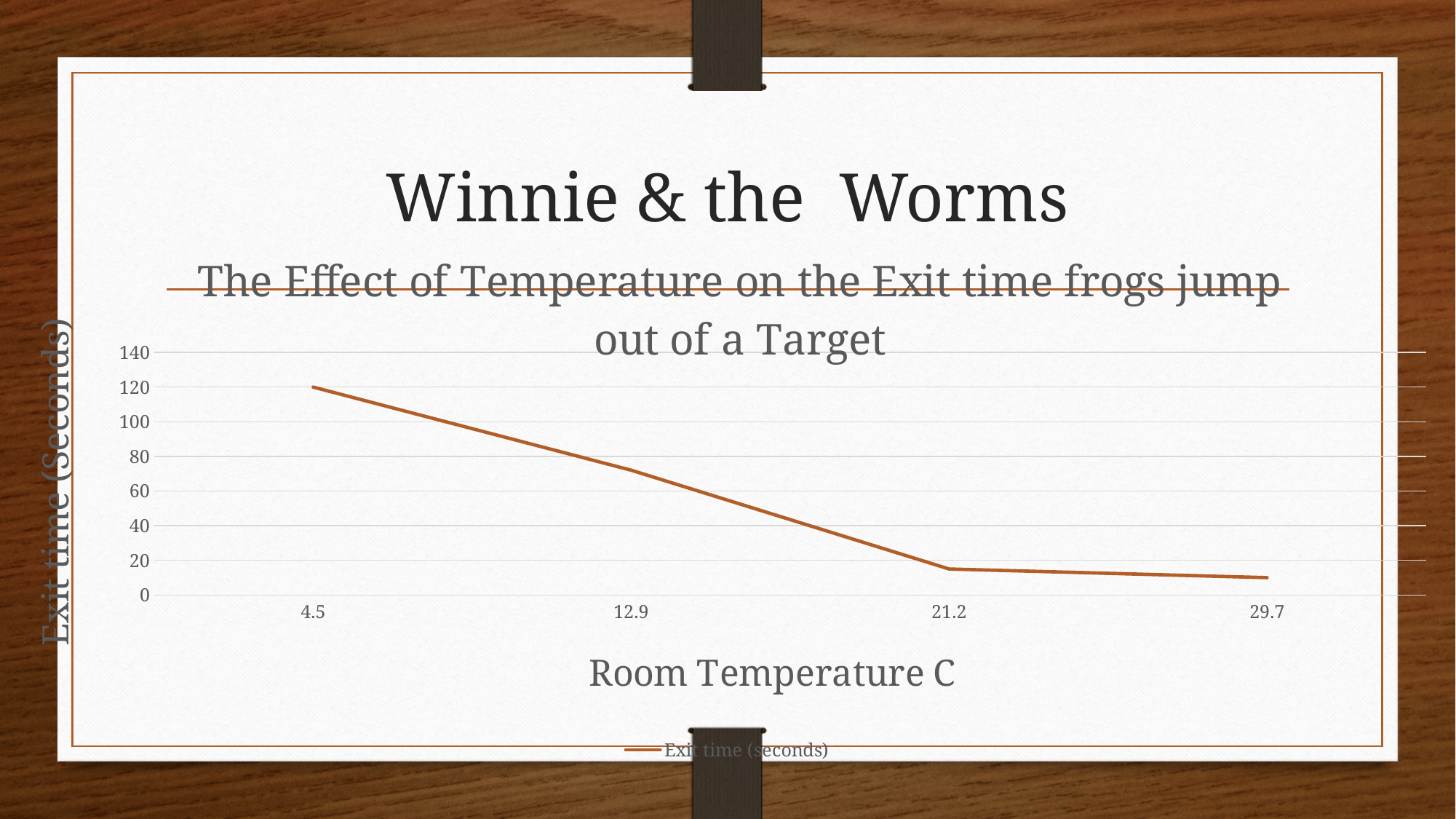
What series name appears in the legend? Exit time (seconds) At which room temperature is the exit time lowest? 29.7 What kind of chart is shown on the slide? line chart How many series does the legend list? 1 At which room temperature is the exit time highest? 4.5 Is the exit time at 21.2 greater or less than 40? less What is the exit time at a room temperature of 4.5? 120 How many room temperature points are plotted on the x axis? 4 Does the exit time rise or fall as room temperature increases along the x axis? fall Which has a larger exit time, 12.9 or 21.2? 12.9 Is the exit time at 12.9 greater or less than 100? less What is the label of the x axis? Room Temperature C